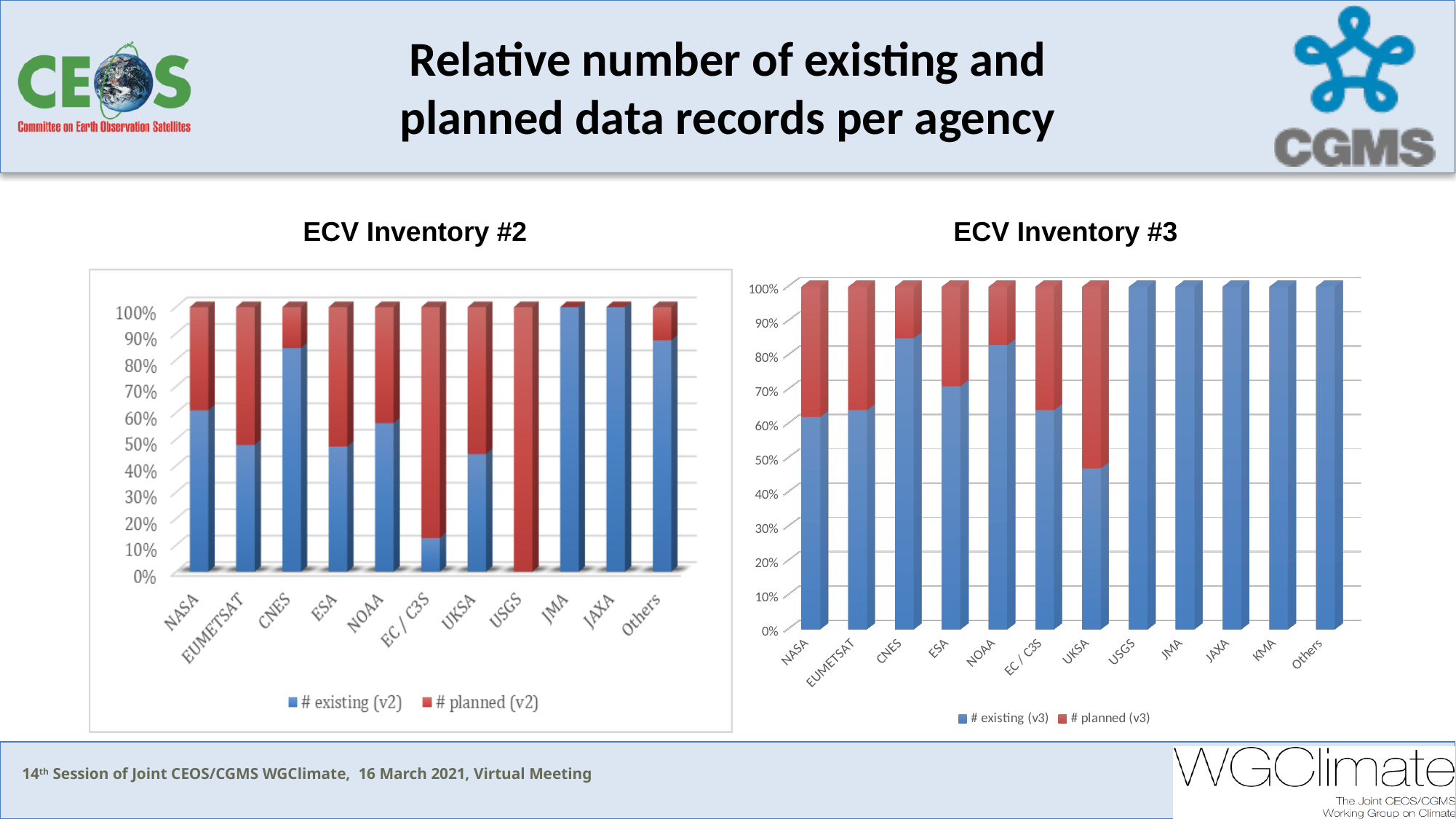
In the ECV Inventory #2 chart, what is the planned share for USGS? 100% In the ECV Inventory #3 chart, is the existing share for UKSA greater or less than 50%? less What kind of chart is the ECV Inventory #3 chart? stacked bar chart In the ECV Inventory #3 chart, which has the larger existing share, NASA or CNES? CNES In the ECV Inventory #3 chart, which agency has the largest planned share? UKSA In the ECV Inventory #3 chart, what is the existing share for USGS? 100% In the ECV Inventory #2 chart, is the existing share for EC / C3S greater or less than 20%? less How many agencies are shown on the x axis of the ECV Inventory #3 chart? 12 In the ECV Inventory #2 chart, which agency has the largest planned share? USGS How many agencies are shown on the x axis of the ECV Inventory #2 chart? 11 What are the two legend entries of the ECV Inventory #3 chart? # existing (v3) and # planned (v3) How many series does the legend of the ECV Inventory #3 chart list? 2